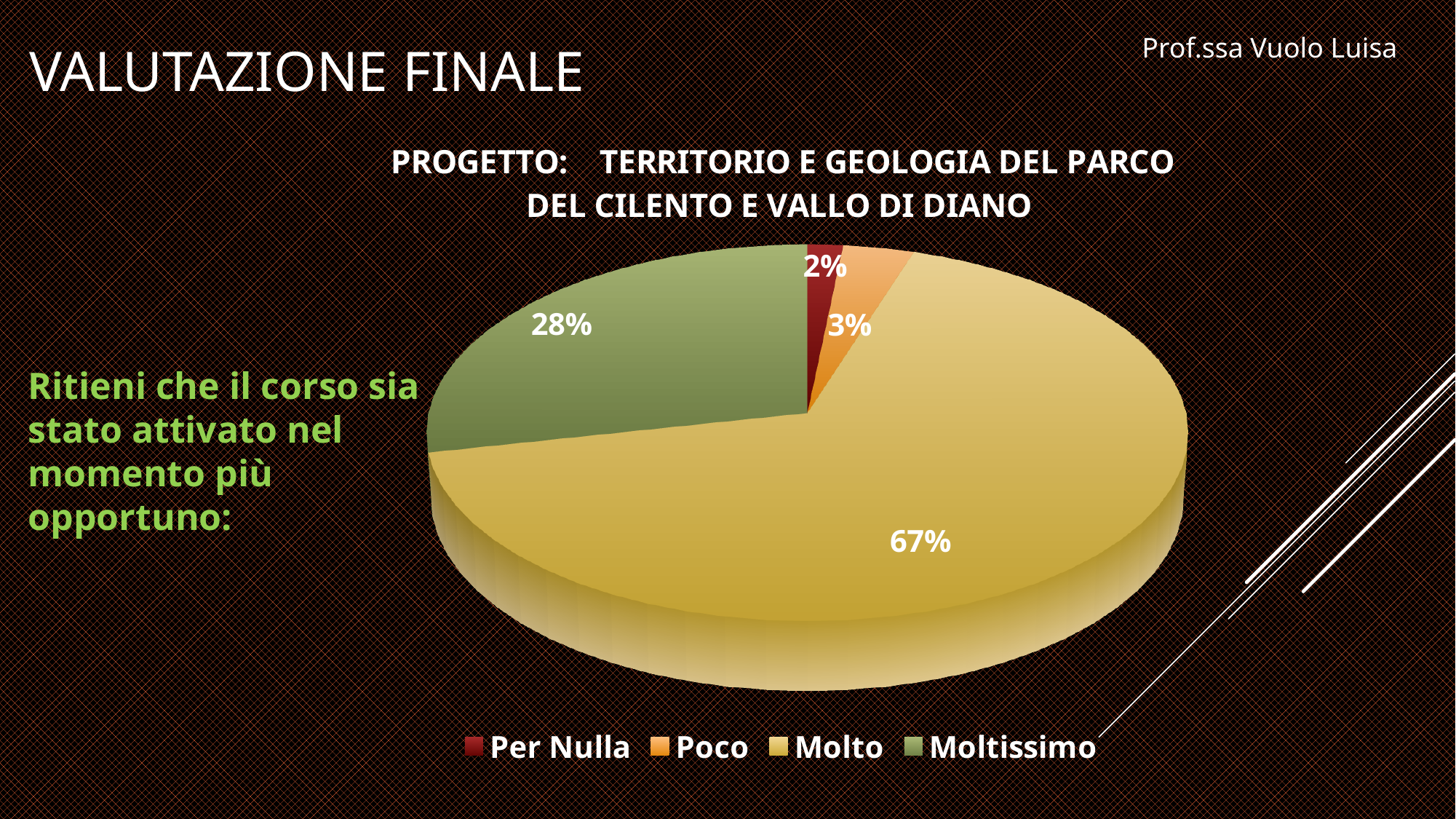
Which category has the smallest slice of the pie? Per Nulla What is the title of the chart? PROGETTO: TERRITORIO E GEOLOGIA DEL PARCO DEL CILENTO E VALLO DI DIANO Which category has the largest slice of the pie? Molto What kind of chart is shown on the slide? pie chart Which is larger, the slice for Poco or the slice for Moltissimo? Moltissimo What percentage of the pie is labelled for Per Nulla? 2% What colour is the slice for Moltissimo? green What percentage of the pie is labelled for Molto? 67% What percentage of the pie is labelled for Poco? 3% What percentage of the pie is labelled for Moltissimo? 28% What is the difference in percentage points between Molto and Moltissimo? 39 How many categories does the legend list? 4